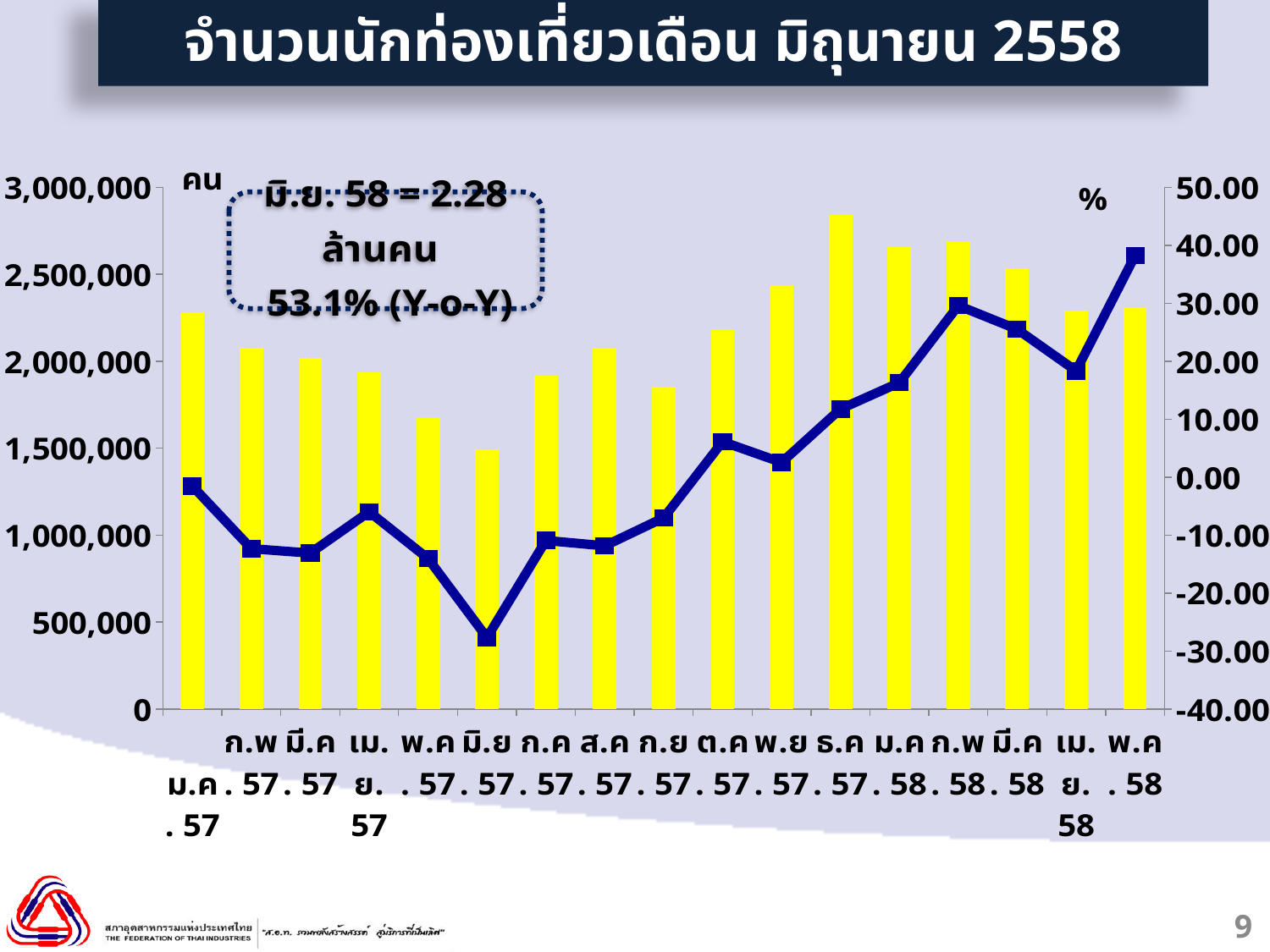
Is the number of tourists for ธ.ค. 57 greater or less than 2,500,000? greater Is the % Y-o-Y value on the line for พ.ค. 58 greater or less than 30.00? greater According to the annotation box, what is the Y-o-Y growth for มิ.ย. 58? 53.1% Which month has the highest point on the navy line (% Y-o-Y)? พ.ค. 58 Is the number of tourists for มิ.ย. 57 greater or less than 2,000,000? less Which month has the shortest yellow bar (lowest number of tourists)? มิ.ย. 57 Which month has the lowest point on the navy line (% Y-o-Y)? มิ.ย. 57 How many months (categories) are plotted along the x axis? 17 Which month has more tourists, ธ.ค. 57 or มิ.ย. 57? ธ.ค. 57 Which month has the tallest yellow bar (highest number of tourists)? ธ.ค. 57 What kind of chart is shown on the slide? A combined bar and line chart